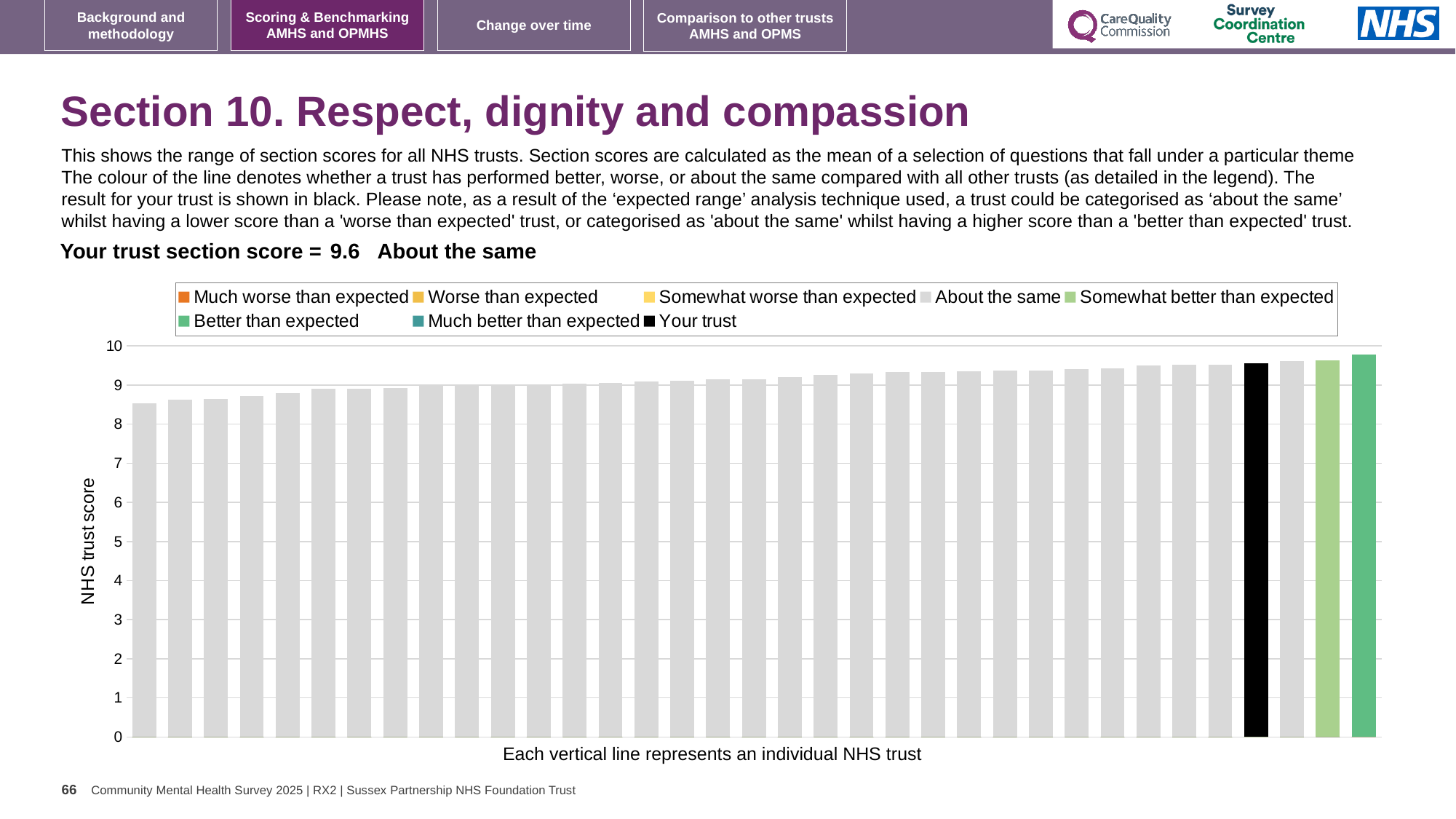
Do the bar values rise or fall from left to right along the x axis? Rise What is the label on the y axis of the chart? NHS trust score What colour is the bar representing your trust? Black What kind of chart is shown on the slide? Bar chart Is the value of the rightmost (highest) bar greater or less than 9? greater Which is larger, the value of the black bar or the value of the leftmost bar? The black bar Is the value for your trust (the black bar) greater or less than 9? greater What is the highest tick value shown on the y axis? 10 How many entries does the chart legend list? 8 Is the value of the leftmost (lowest) bar greater or less than 9? less What is the section score for your trust shown on the slide? 9.6 Which category is your trust's section score placed in? About the same